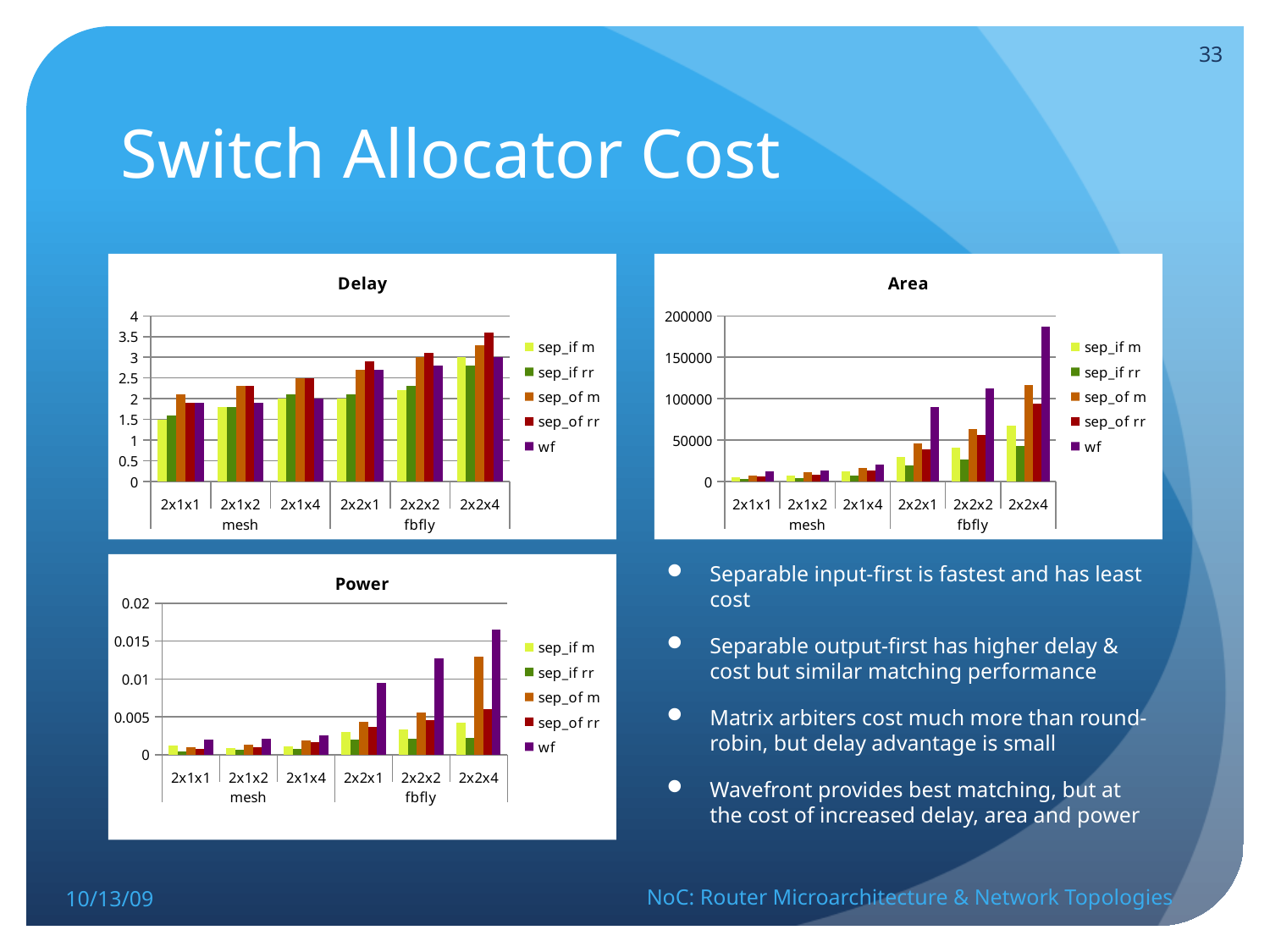
In the Area chart at 2x2x1, which is larger: wf or sep_of rr? wf How many configuration categories are shown along the x axis of the Power chart? 6 In the Area chart, is the value for wf at 2x2x4 greater or less than 150000? greater In the Area chart, which series has the tallest bar overall? wf What kind of chart is the Delay chart? bar chart In the Delay chart, which series has the tallest bar at 2x2x4? sep_of rr In the Delay chart, is the value for sep_if m at 2x1x1 greater or less than 2? less In the Area chart, is the value for sep_of m at 2x2x4 greater or less than 100000? greater How many series does the legend of the Area chart list? 5 Which two topology groups are labelled on the x axis of the Power chart? mesh and fbfly In the Delay chart at 2x1x1, which is larger: sep_if m or sep_of m? sep_of m